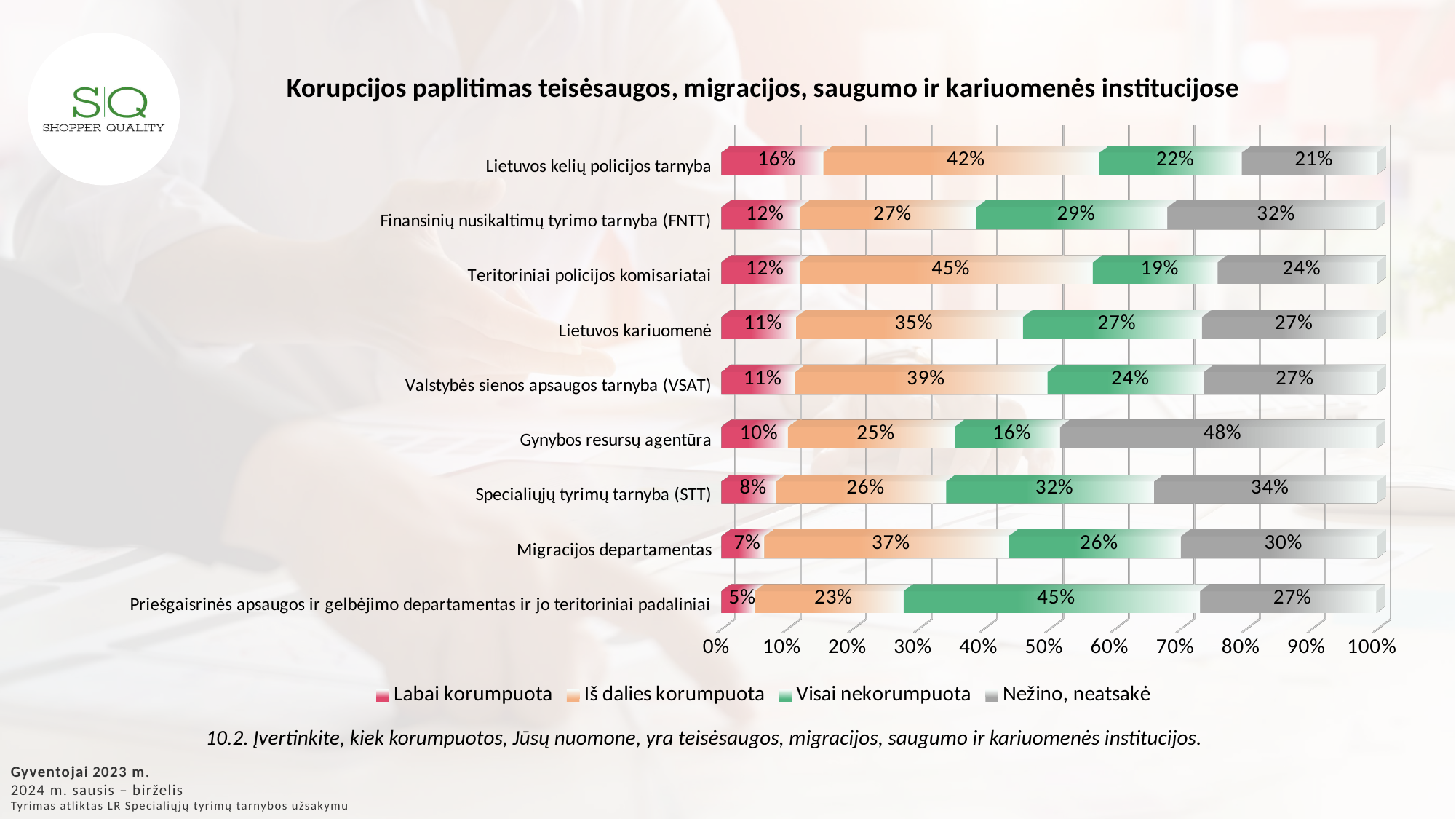
Which institution has the highest 'Labai korumpuota' value? Lietuvos kelių policijos tarnyba What is the 'Labai korumpuota' value for Lietuvos kelių policijos tarnyba? 16% What type of chart is shown on the slide? Stacked bar chart What is the 'Nežino, neatsakė' value for Gynybos resursų agentūra? 48% What is the title of the chart? Korupcijos paplitimas teisėsaugos, migracijos, saugumo ir kariuomenės institucijose How many series does the legend list? 4 What is the difference between the 'Iš dalies korumpuota' values for Teritoriniai policijos komisariatai and Gynybos resursų agentūra? 20% What is the total of the stacked bar for Specialiųjų tyrimų tarnyba (STT)? 100% What is the 'Visai nekorumpuota' value for Priešgaisrinės apsaugos ir gelbėjimo departamentas ir jo teritoriniai padaliniai? 45% How many institutions (categories) are shown in the chart? 9 Which institution has the lowest 'Labai korumpuota' value? Priešgaisrinės apsaugos ir gelbėjimo departamentas ir jo teritoriniai padaliniai Which is larger: the 'Visai nekorumpuota' value for Specialiųjų tyrimų tarnyba (STT) or for Migracijos departamentas? Specialiųjų tyrimų tarnyba (STT)